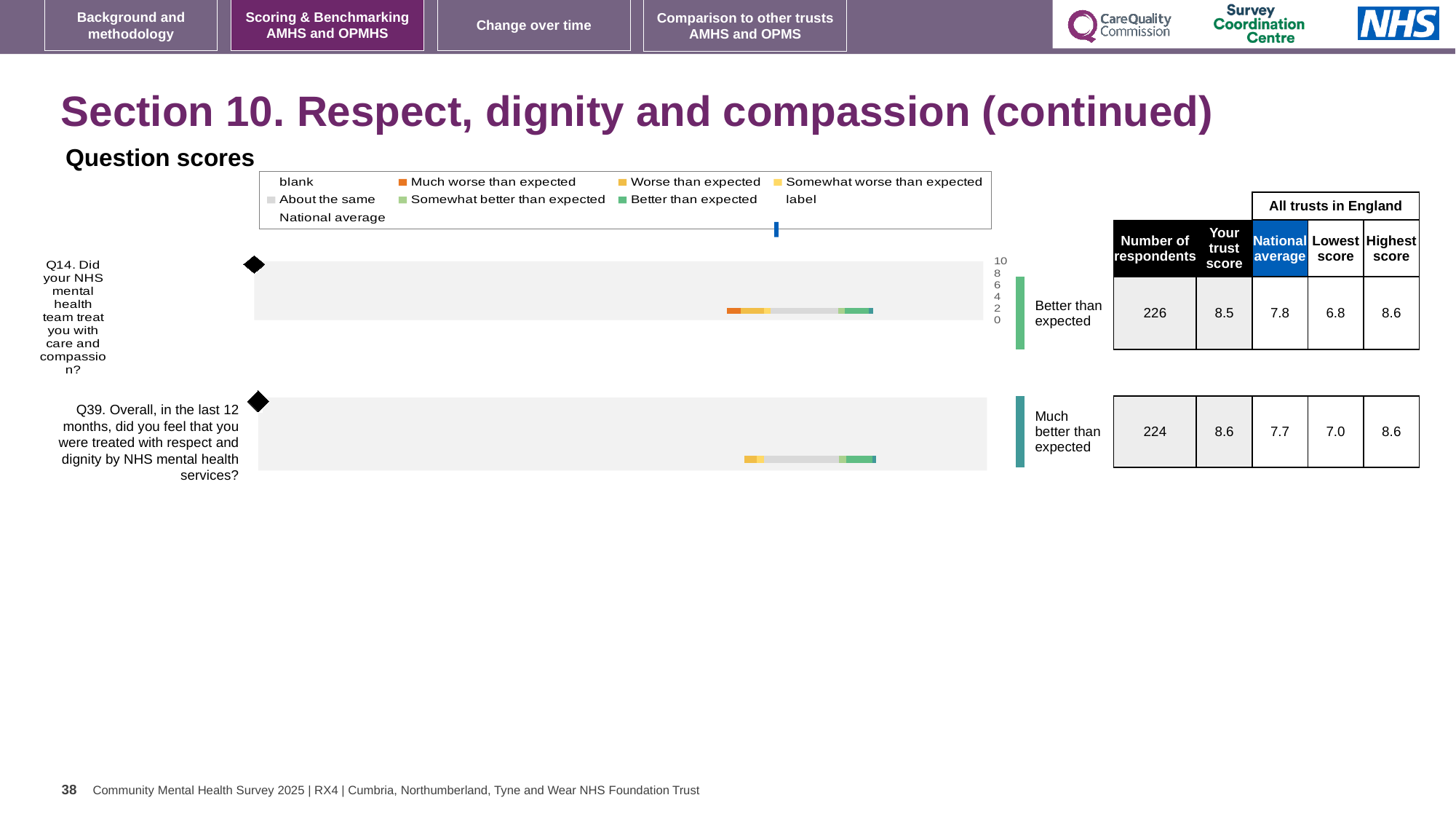
What benchmark category is shown for Q39 in the Question scores chart? Much better than expected What is the national average score for Q14? 7.8 What is the lowest score among all trusts in England for Q39? 7.0 What kind of chart is the Question scores chart? Bar chart What benchmark category is shown for Q14 in the Question scores chart? Better than expected How many respondents are shown for Q14 in the table next to the chart? 226 By how much does the trust score for Q14 exceed the national average for Q14? 0.7 Which question has the higher trust score, Q14 or Q39? Q39 What is the highest score among all trusts in England for Q14? 8.6 How many questions are plotted in the Question scores chart? 2 What is the 'Your trust score' value for Q39? 8.6 What is the difference between the highest and lowest scores for Q39? 1.6